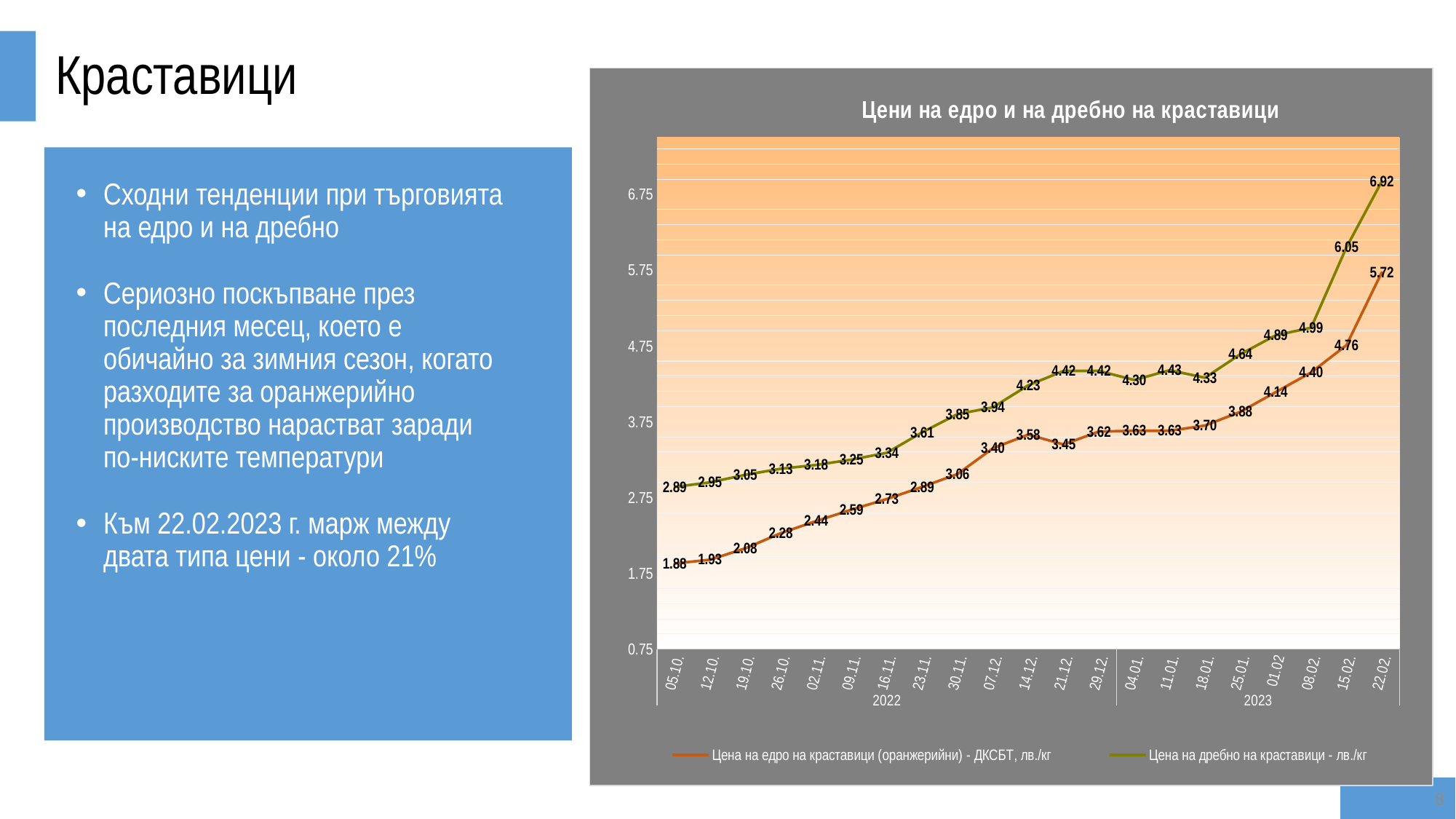
What is the retail price (Цена на дребно) on 15.02.? 6.05 What is the wholesale price (Цена на едро) on 22.02.? 5.72 Which is larger on 21.12.: the wholesale price or the retail price? the retail price Does the wholesale price (Цена на едро) generally rise or fall from 05.10. to 22.02.? rise What is the retail price (Цена на дребно) on 05.10.? 2.89 On which date is the retail price (Цена на дребно) highest? 22.02. How many series does the legend list? 2 What type of chart is shown on the slide? line chart What is the difference between the retail price and the wholesale price on 22.02.? 1.20 How many data points are plotted for each series along the x axis? 21 What is the title of the chart? Цени на едро и на дребно на краставици On which date is the wholesale price (Цена на едро) lowest? 05.10.